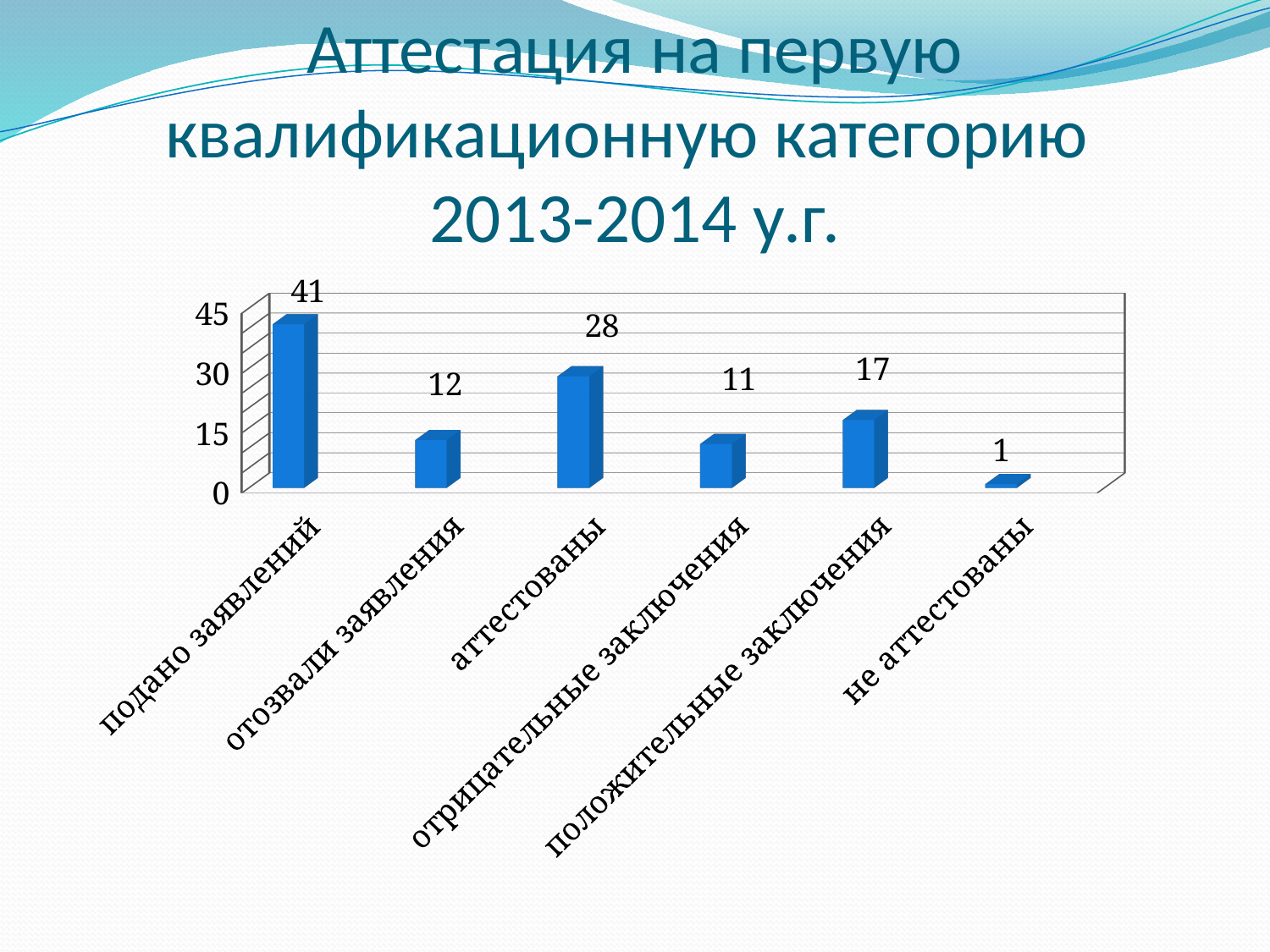
What is the value for "не аттестованы"? 1 Which category has the lowest value? не аттестованы What is the value for "отозвали заявления"? 12 Which category has the highest value? подано заявлений What is the value for "подано заявлений"? 41 Which is larger, "положительные заключения" or "отрицательные заключения"? положительные заключения How many categories are shown on the chart? 6 What is the value for "аттестованы"? 28 What is the value for "положительные заключения"? 17 What is the difference between "подано заявлений" and "аттестованы"? 13 What is the title of the slide? Аттестация на первую квалификационную категорию 2013-2014 у.г. What kind of chart is shown on the slide? bar chart